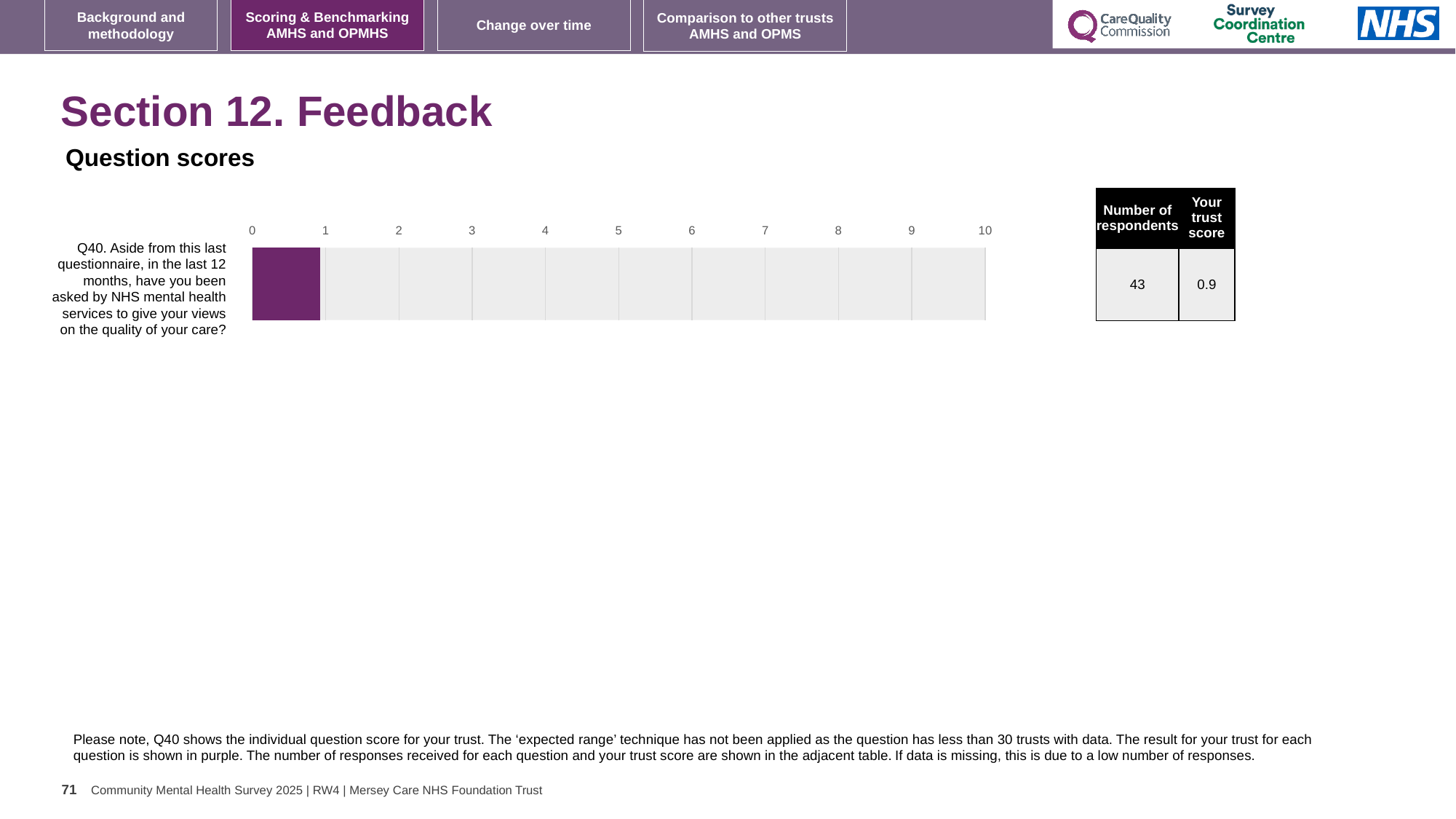
What kind of chart is shown on the slide? bar chart Is the value for Q40 greater or less than 1? less Is the value for Q40 greater or less than 5? less How many respondents answered Q40 according to the table? 43 What is the trust score for Q40 shown on the slide? 0.9 What is the maximum value shown on the chart's axis? 10 What colour is the bar for Q40? purple What is the heading above the chart? Question scores How many questions (bars) are plotted in the chart? 1